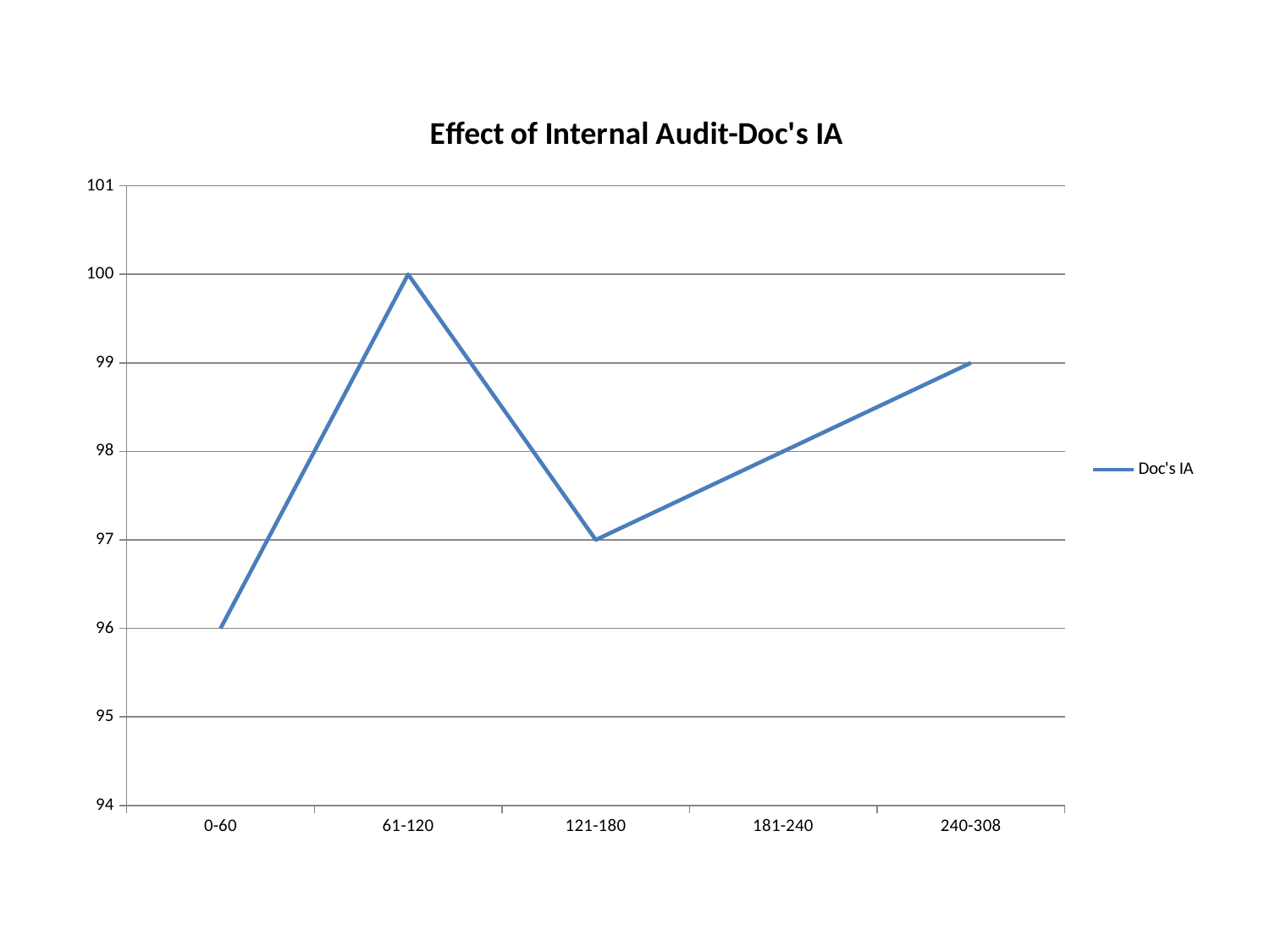
What is the difference between the Doc's IA values for 61-120 and 0-60? 4 What is the value of Doc's IA for the 240-308 category? 99 What type of chart is shown on the slide? line chart What is the value of Doc's IA for the 121-180 category? 97 How many series does the legend list? 1 Which category has the lowest value for Doc's IA? 0-60 How many categories are shown on the x axis? 5 What is the title of the chart? Effect of Internal Audit-Doc's IA What is the value of Doc's IA for the 61-120 category? 100 Does the value of Doc's IA rise or fall from 121-180 to 240-308? rise What is the value of Doc's IA for the 0-60 category? 96 Which category has the highest value for Doc's IA? 61-120